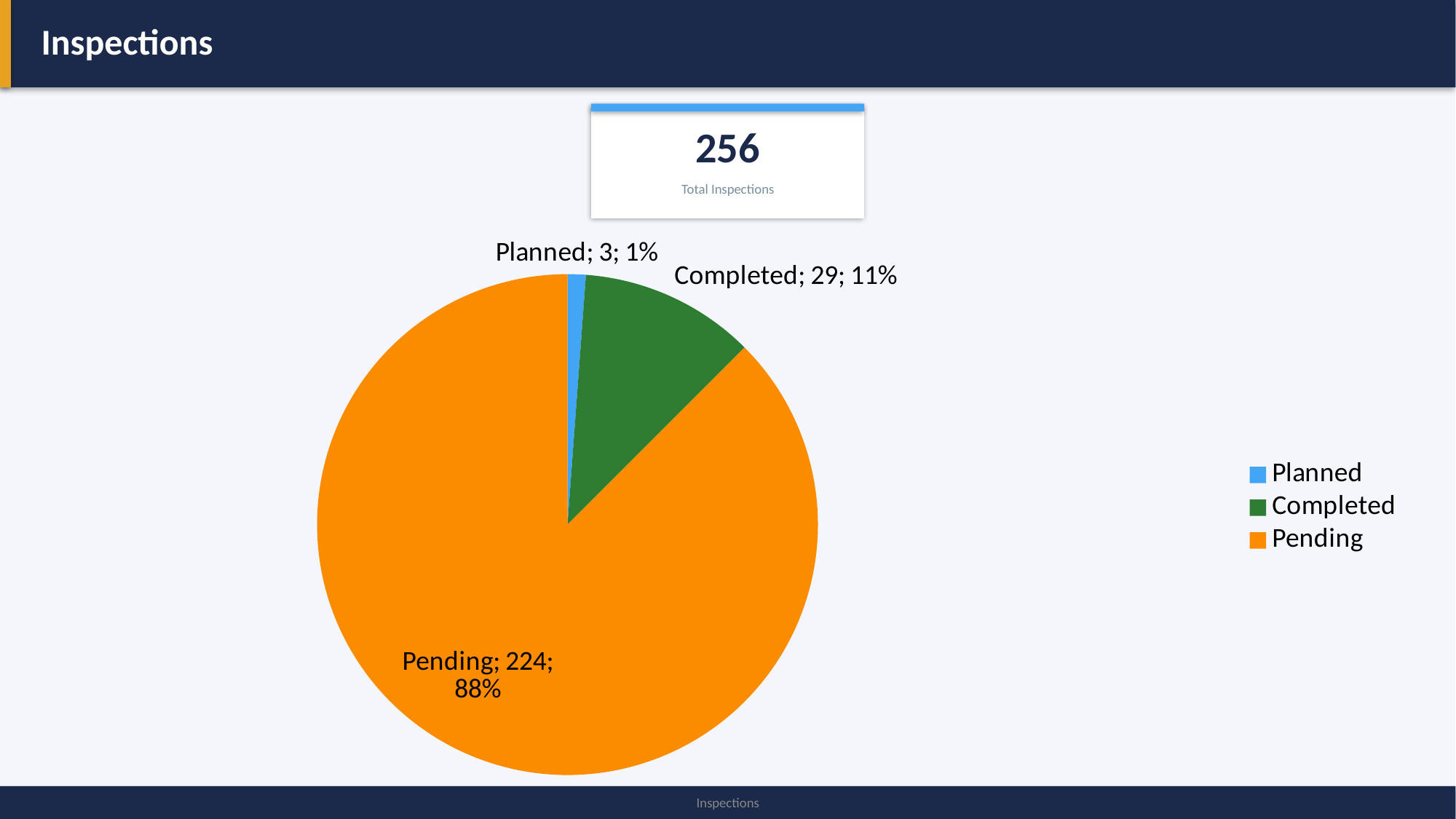
What share of the pie does the Pending slice represent? 88% What colour is the Pending slice? orange Which is larger, Completed or Planned? Completed How many inspections are Completed? 29 What is the difference between the Pending and Completed counts? 195 What share of the pie does the Completed slice represent? 11% How many categories does the pie chart have? 3 Which category has the largest slice? Pending What kind of chart is shown on the slide? pie chart How many inspections are Planned? 3 How many inspections are Pending? 224 Which category has the smallest slice? Planned